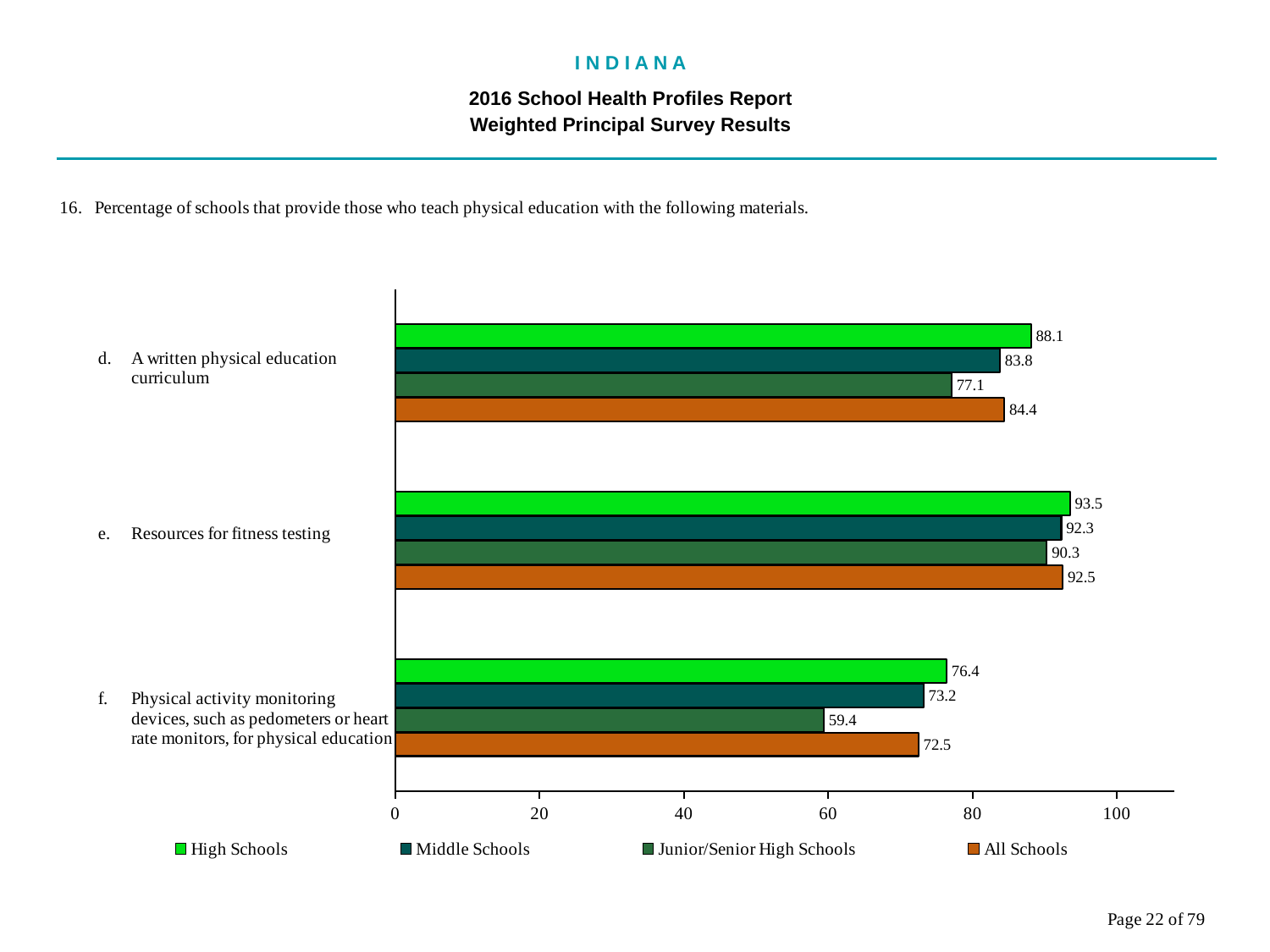
What is the difference between the High Schools and Middle Schools values for physical activity monitoring devices? 3.2 What kind of chart is shown on the slide? Bar chart Which school type has the lowest value for a written physical education curriculum? Junior/Senior High Schools Which series is shown in orange in the legend? All Schools Is the Junior/Senior High Schools value for physical activity monitoring devices greater or less than 60? less What is the All Schools value for resources for fitness testing? 92.5 Which school type has the highest value for resources for fitness testing? High Schools How many materials (categories) are shown on the chart? 3 How many series does the legend list? 4 Which is larger for Middle Schools: the value for a written physical education curriculum or for resources for fitness testing? Resources for fitness testing What percentage of High Schools provide a written physical education curriculum? 88.1 What is the value for Junior/Senior High Schools for physical activity monitoring devices? 59.4